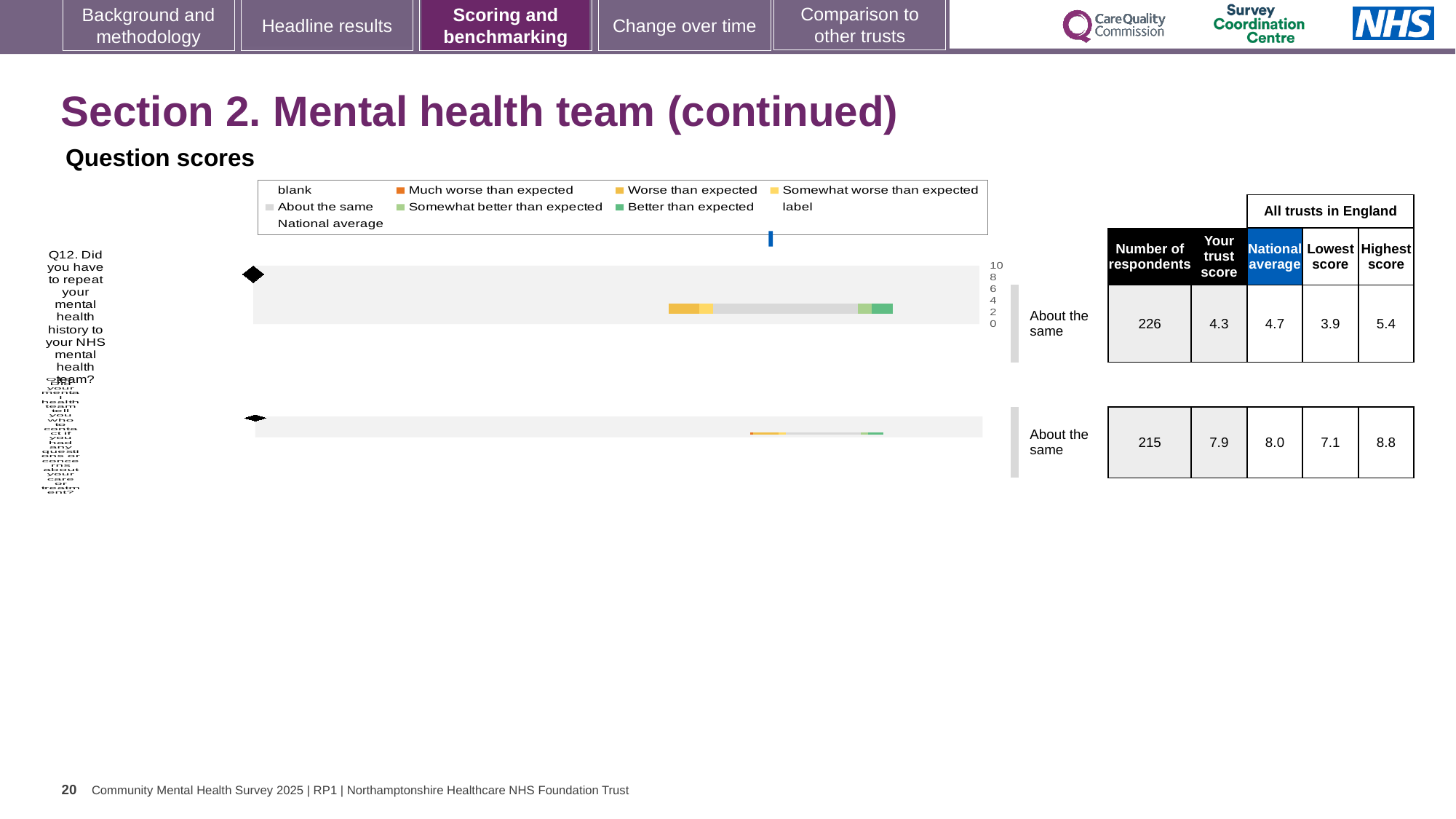
What kind of chart is used to show the Q12 question score? bar chart For the Q12 chart, what is the difference between the highest score and the lowest score across all trusts in England? 1.5 For the lower (second) chart on the slide, what is the trust's score? 7.9 In the legend, what colour represents 'Better than expected'? green For the Q12 chart, how many respondents are listed? 226 In the legend, what colour represents 'Much worse than expected'? orange For the Q12 chart (repeating mental health history), what is the trust's score shown in the table? 4.3 For the lower (second) chart on the slide, what is the highest score across all trusts in England? 8.8 For the Q12 chart, what benchmark category is the trust's result placed in? About the same For the Q12 chart, which is larger: the trust score or the national average? national average How many question score charts are shown on the slide? 2 For the Q12 chart, what is the national average score? 4.7